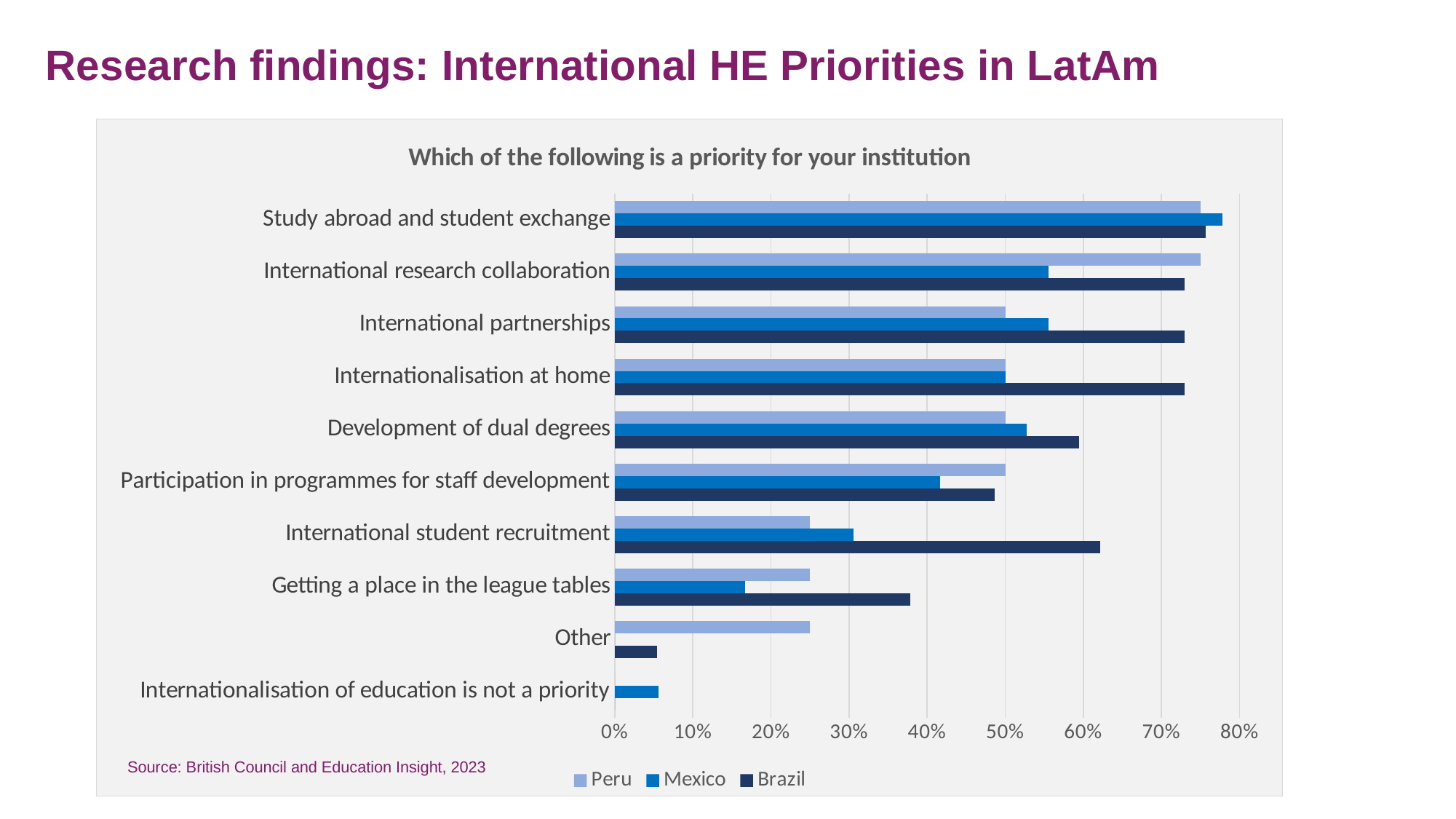
For International student recruitment, which is larger: the value for Brazil or the value for Mexico? Brazil Is the value for Peru for Study abroad and student exchange greater or less than 70%? greater How many categories are plotted on the chart? 10 Is the value for Brazil for Internationalisation at home greater or less than 70%? greater Which country has the lowest value for International partnerships? Peru What is the title of the chart? Which of the following is a priority for your institution Is the value for Brazil for International student recruitment greater or less than 60%? greater How many series does the legend list? 3 For International research collaboration, which is larger: the value for Peru or the value for Mexico? Peru Which countries are listed in the chart legend? Peru, Mexico, Brazil What kind of chart is shown on the slide? bar chart